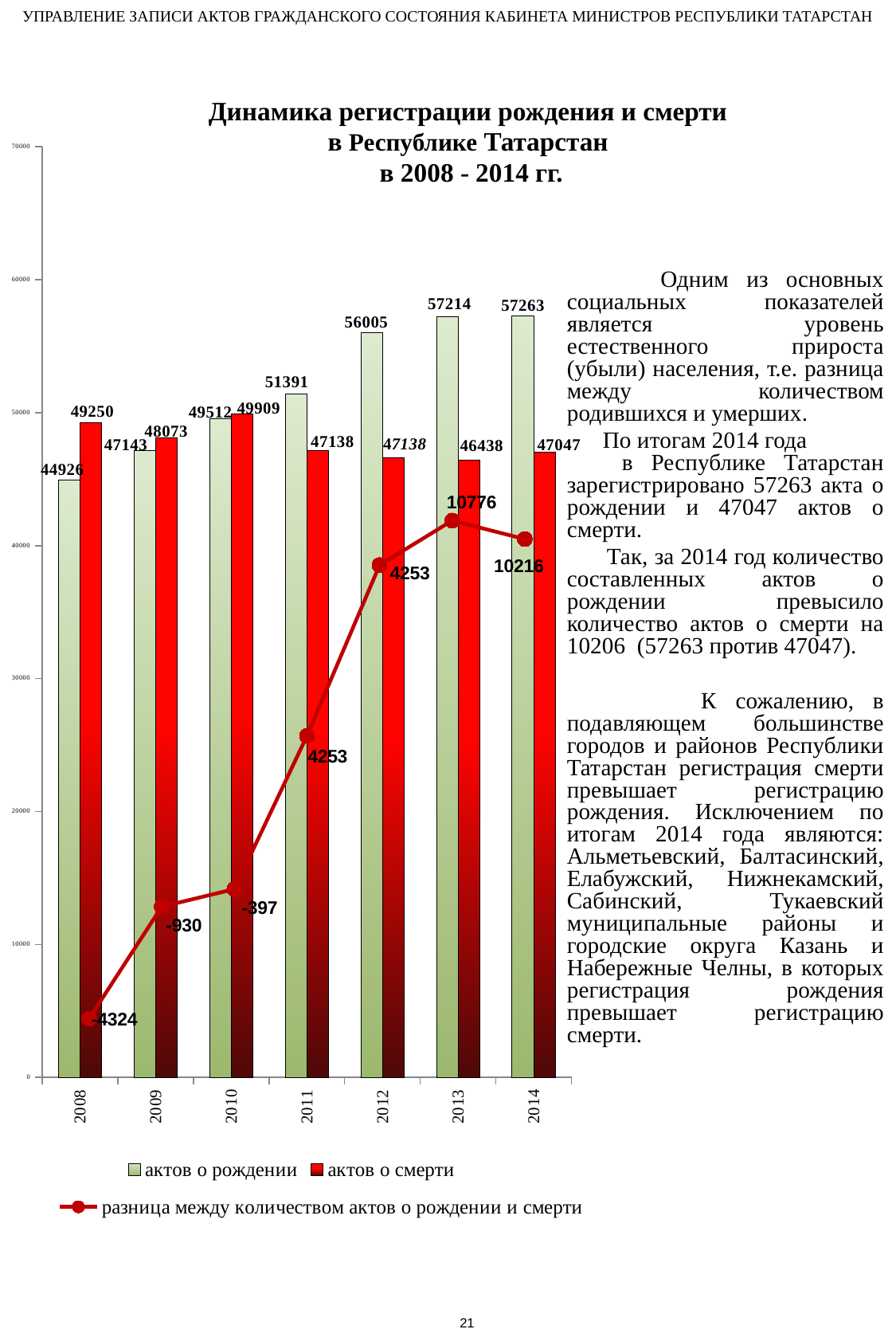
How many birth records (актов о рождении) were registered in 2014? 57263 What is the value for death records (актов о смерти) in 2008? 49250 In which year was the number of death records (актов о смерти) the lowest? 2013 In which year was the number of birth records (актов о рождении) the lowest? 2008 What kind of chart is this? Bar chart with a line series How many series does the legend list? 3 In which year was the number of death records (актов о смерти) the highest? 2010 By how much did birth records exceed death records in 2014 (57263 vs 47047)? 10216 How many years are shown on the x axis of the chart? 7 Do the birth records (актов о рождении) rise or fall from 2008 to 2014? Rise In 2010, which was larger: birth records or death records? Death records (актов о смерти) What is the value of the difference line (разница между количеством актов о рождении и смерти) for 2008? -4324